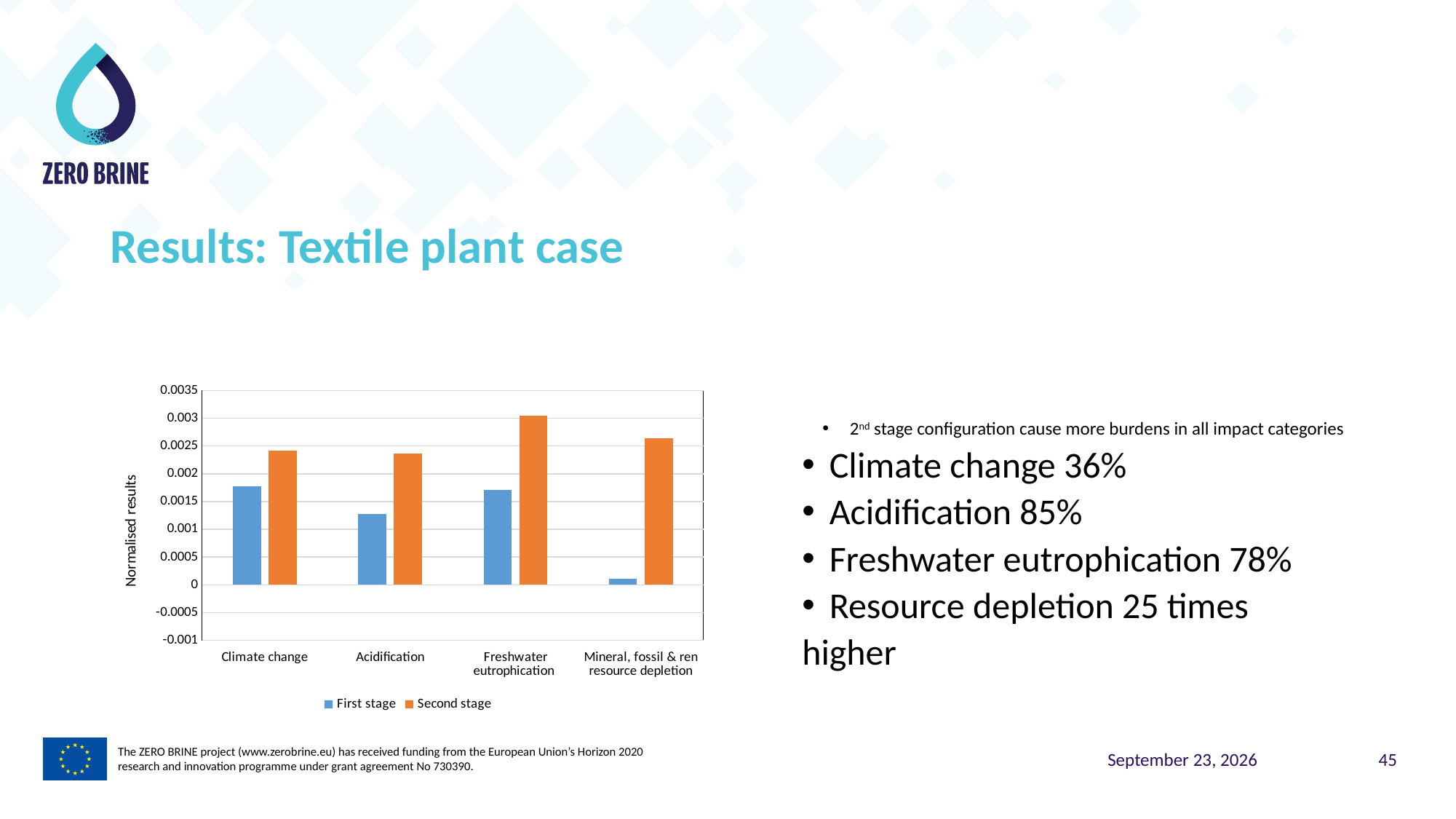
For which category is the Second stage value highest? Freshwater eutrophication What is the label of the y axis of the chart? Normalised results Is the First stage value for Mineral, fossil & ren resource depletion greater or less than 0.0005? less How many impact categories are shown on the x axis of the chart? 4 For which category is the First stage value lowest? Mineral, fossil & ren resource depletion Which series is shown in orange in the chart? Second stage How many series does the chart legend list? 2 Is the First stage value for Acidification greater or less than 0.0015? less What kind of chart is shown on the slide? bar chart Is the Second stage value for Freshwater eutrophication greater or less than 0.0025? greater For Acidification, which is larger: the First stage value or the Second stage value? Second stage